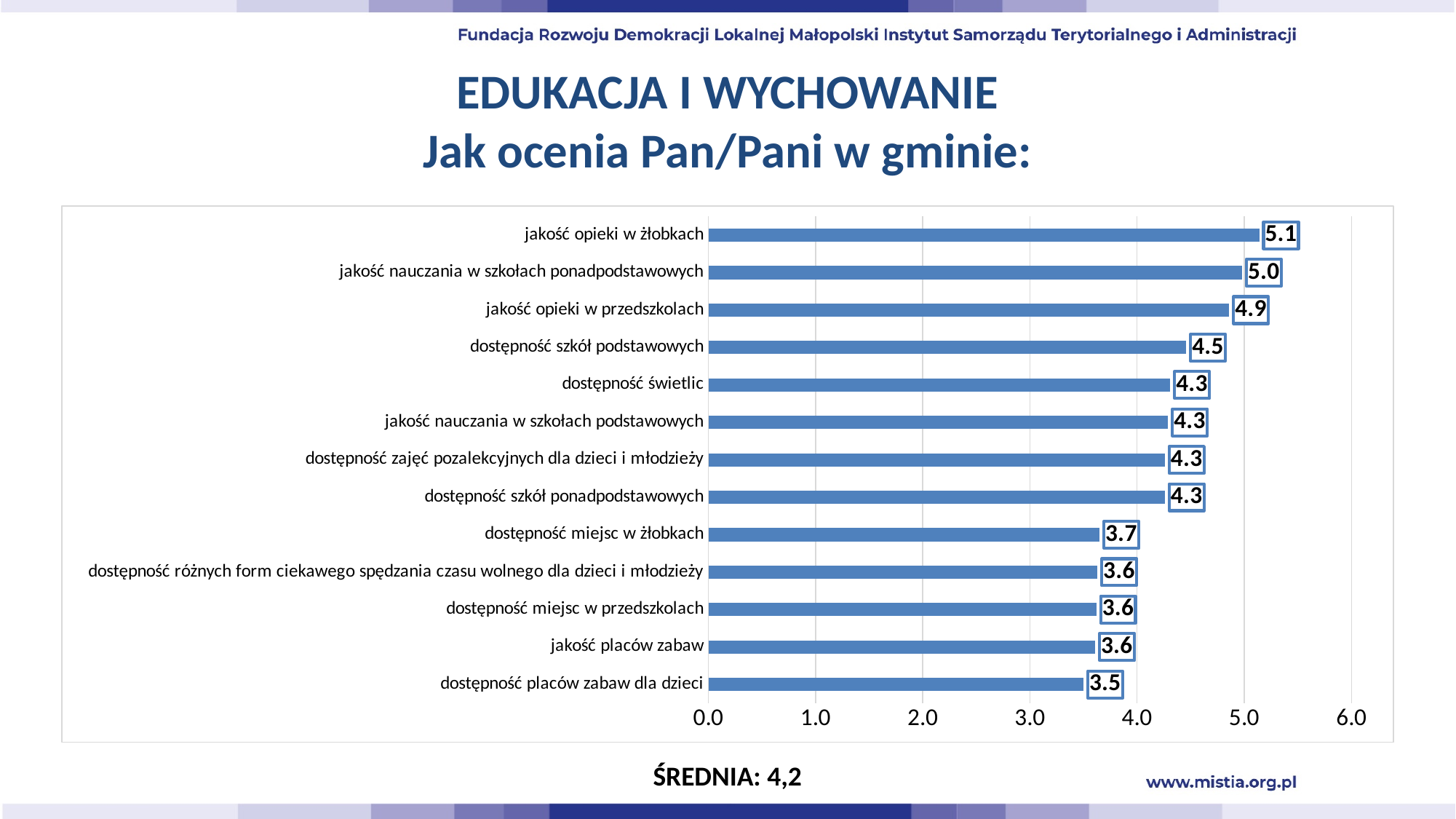
What average (ŚREDNIA) is stated below the chart? 4,2 How many categories are shown in the chart? 13 What is the value for "jakość opieki w żłobkach"? 5.1 What is the value for "dostępność miejsc w żłobkach"? 3.7 Which category has the highest value? jakość opieki w żłobkach Which category has the lowest value? dostępność placów zabaw dla dzieci What is the difference between the values for "jakość opieki w przedszkolach" and "dostępność miejsc w przedszkolach"? 1.3 What kind of chart is shown on the slide? bar chart What is the difference between the values for "jakość opieki w żłobkach" and "dostępność placów zabaw dla dzieci"? 1.6 What is the value for "dostępność szkół podstawowych"? 4.5 Which is larger: the value for "jakość nauczania w szkołach ponadpodstawowych" or the value for "dostępność szkół ponadpodstawowych"? jakość nauczania w szkołach ponadpodstawowych Is the value for "dostępność świetlic" greater or less than 4.0? greater